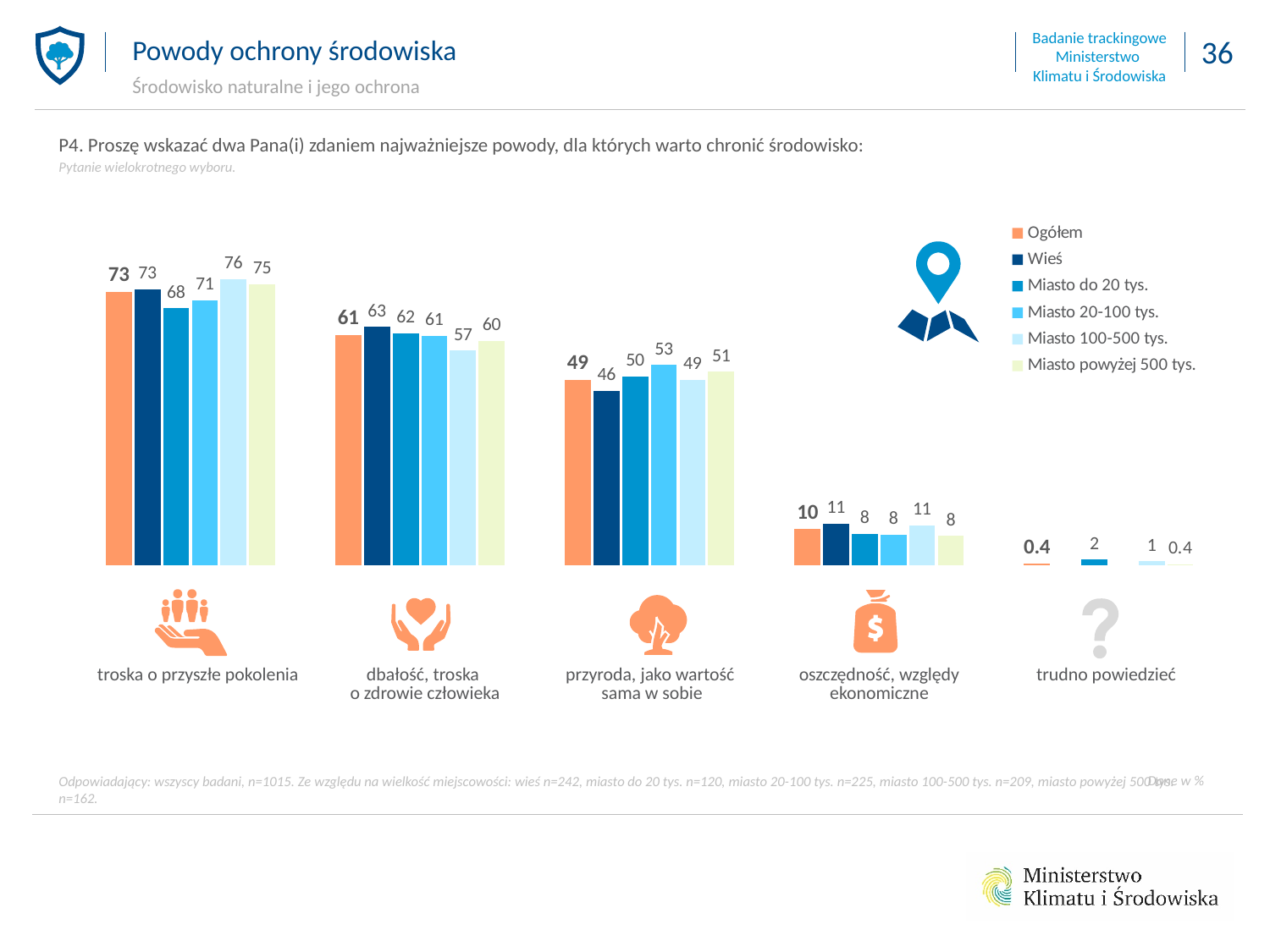
What is the Ogółem value for "trudno powiedzieć"? 0.4 What is the value for Miasto 20-100 tys. in the "przyroda, jako wartość sama w sobie" category? 53 What is the difference between the Miasto 100-500 tys. value and the Miasto do 20 tys. value for "troska o przyszłe pokolenia"? 8 What is the Ogółem value for "oszczędność, względy ekonomiczne"? 10 For "dbałość, troska o zdrowie człowieka", which is larger: the Wieś value or the Miasto 100-500 tys. value? Wieś What is the value for Miasto 100-500 tys. in the "troska o przyszłe pokolenia" category? 76 What is the Ogółem value for "troska o przyszłe pokolenia"? 73 How many series does the legend list? 6 Which category has the highest Ogółem value? troska o przyszłe pokolenia Which category has the lowest Ogółem value? trudno powiedzieć What kind of chart is shown on the slide? bar chart What is the Wieś value for "dbałość, troska o zdrowie człowieka"? 63